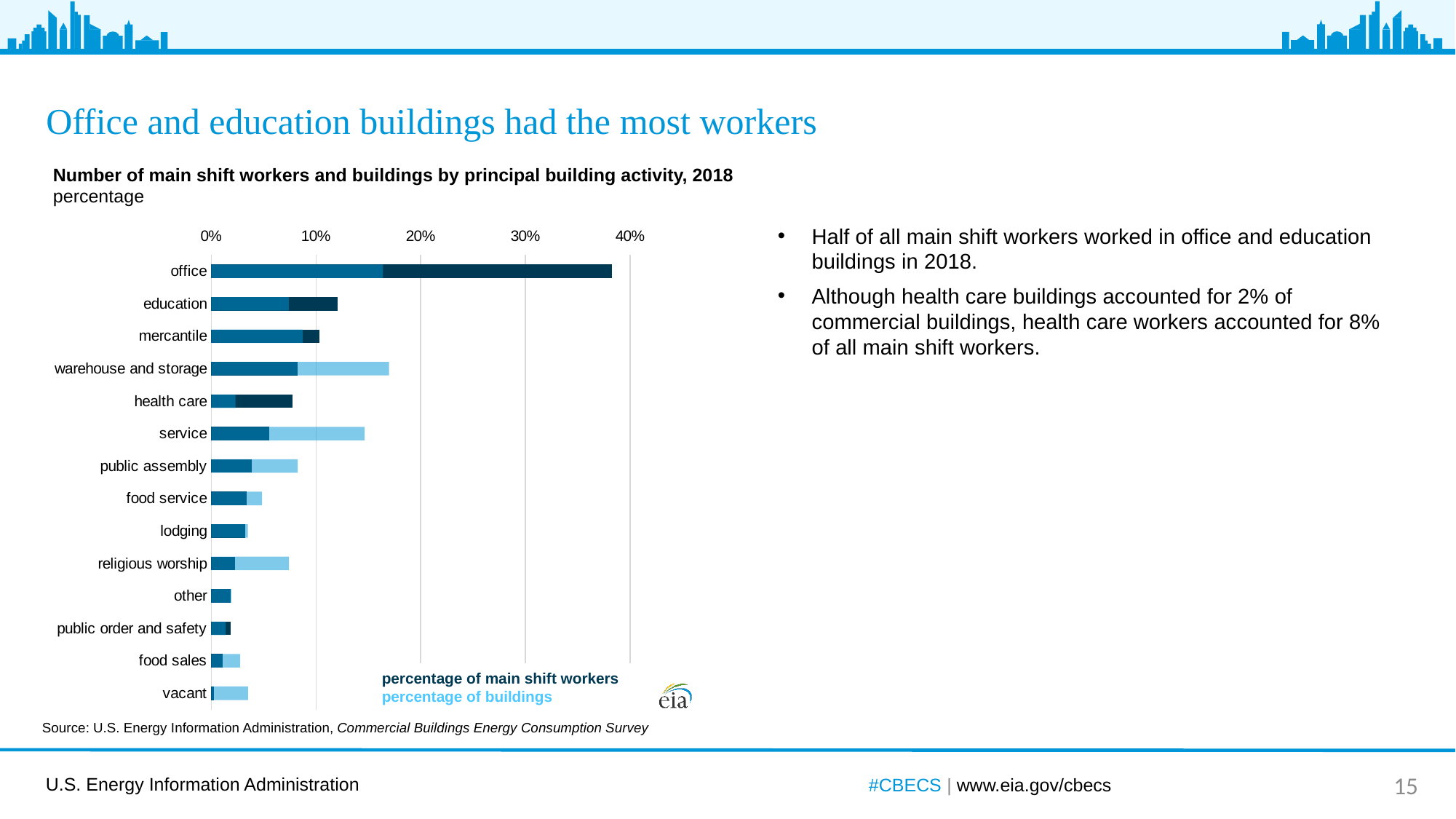
Is the percentage of buildings for warehouse and storage greater or less than 10%? greater What is the title of the chart? Number of main shift workers and buildings by principal building activity, 2018 What kind of chart is shown on the slide? bar chart How many series does the chart legend list? 2 Which is larger for health care: the percentage of main shift workers or the percentage of buildings? percentage of main shift workers Which building activity has the highest percentage of main shift workers? office How many building activity categories are listed on the chart? 14 Is the percentage of main shift workers for health care greater or less than 10%? less Which building activity has the lowest percentage of main shift workers? vacant Is the percentage of main shift workers for office greater or less than 30%? greater Which has a larger percentage of main shift workers, office or education? office